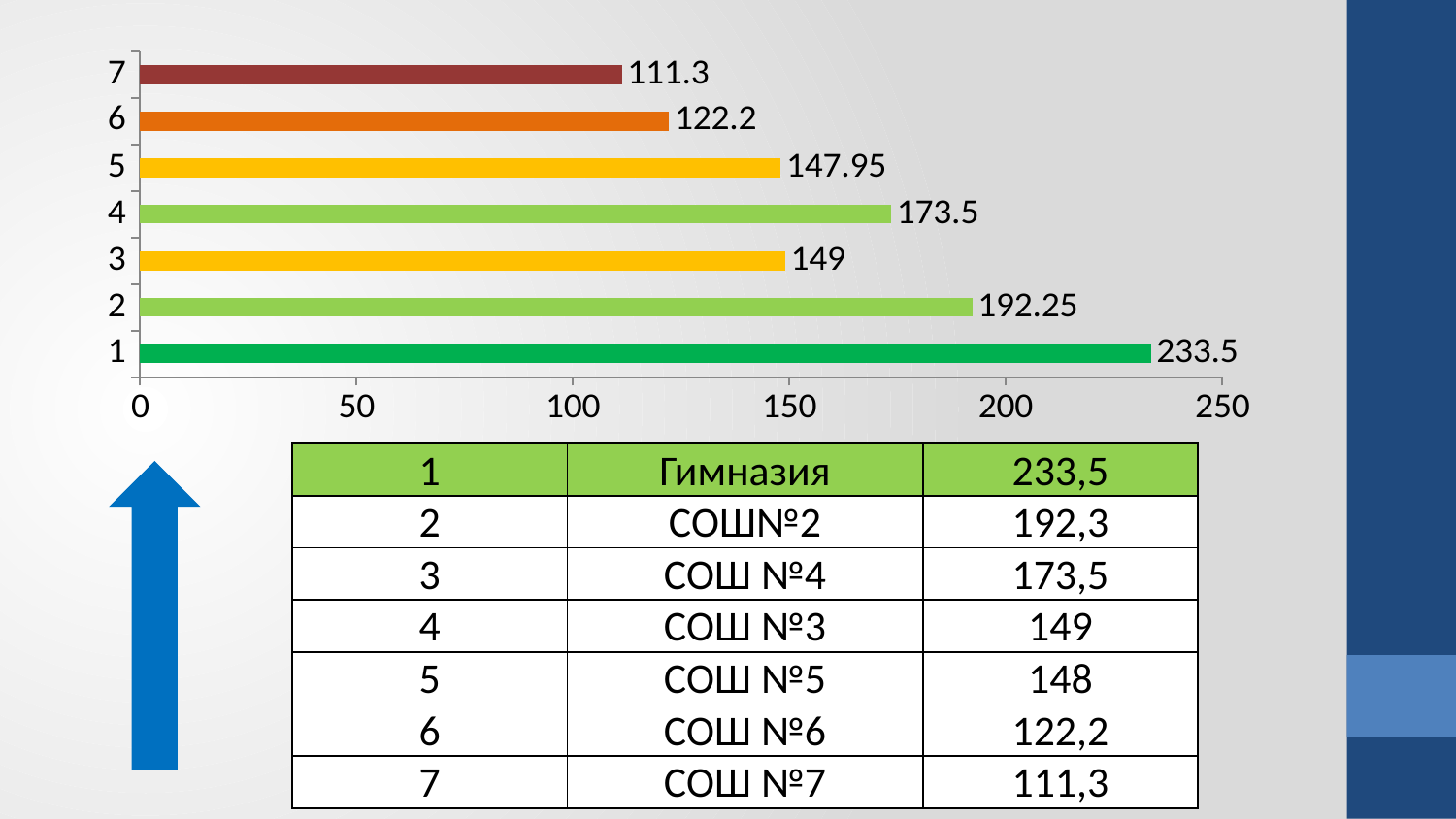
What is the value for category 7? 111.3 What is the value for category 5? 147.95 What is the difference between the values for category 1 and category 7? 122.2 What is the value for category 2? 192.25 What kind of chart is shown on the slide? bar chart How many categories are shown in the chart? 7 Is the value for category 2 greater or less than 200? less Which category has the lowest value? 7 Which category has the highest value? 1 Which has a larger value, category 4 or category 6? 4 What is the difference between the values for category 4 and category 3? 24.5 What is the value for category 1? 233.5